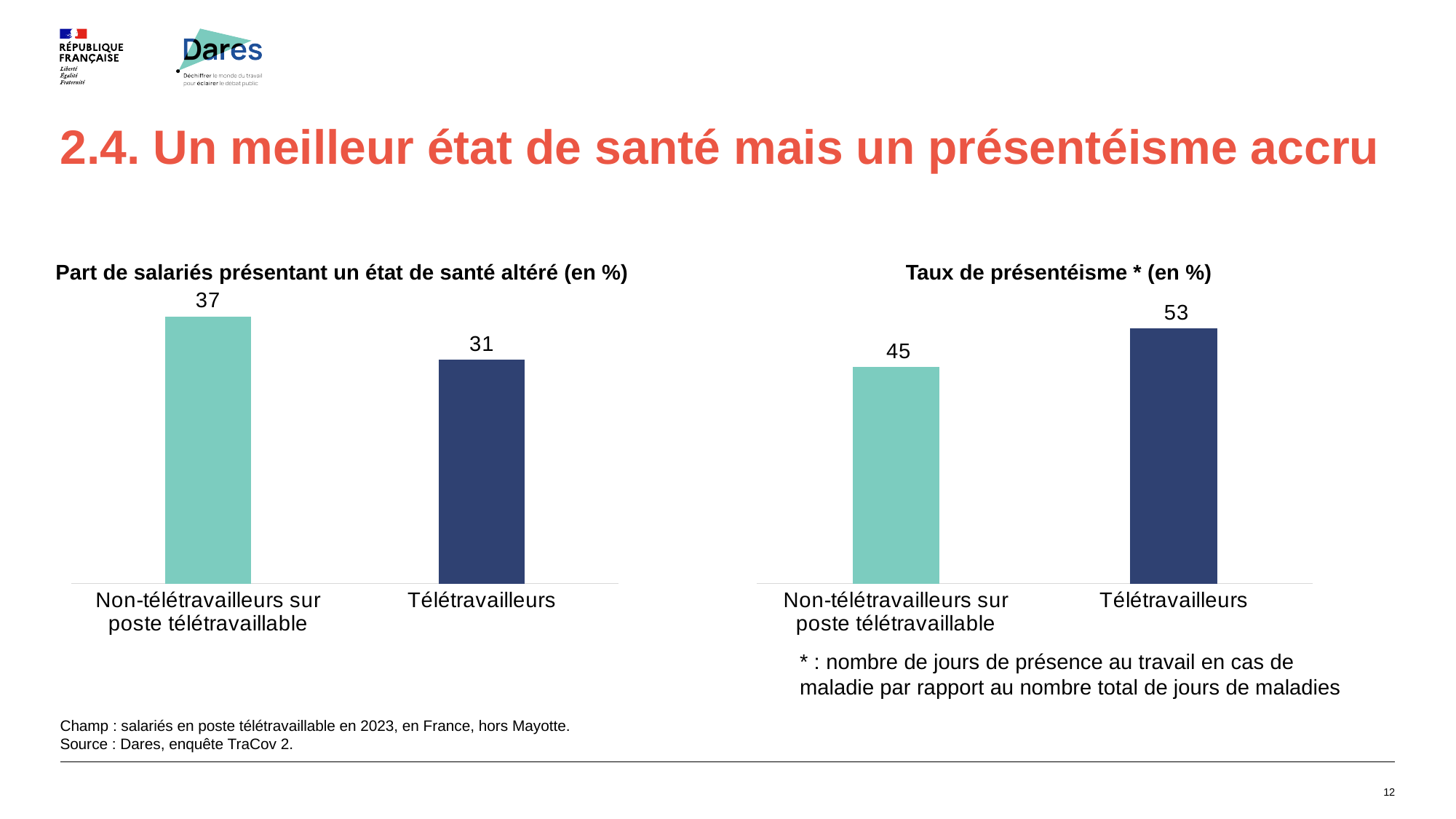
How many charts are shown on the slide? 2 What type of chart is the chart 'Taux de présentéisme * (en %)'? Bar chart In the chart 'Part de salariés présentant un état de santé altéré (en %)', which category has the highest value? Non-télétravailleurs sur poste télétravaillable In the chart 'Taux de présentéisme * (en %)', what is the value for Non-télétravailleurs sur poste télétravaillable? 45 In the chart 'Part de salariés présentant un état de santé altéré (en %)', what is the value for Télétravailleurs? 31 In the chart 'Taux de présentéisme * (en %)', what is the difference between the values for Télétravailleurs and Non-télétravailleurs sur poste télétravaillable? 8 In the chart 'Taux de présentéisme * (en %)', what is the value for Télétravailleurs? 53 In the chart 'Part de salariés présentant un état de santé altéré (en %)', what is the value for Non-télétravailleurs sur poste télétravaillable? 37 In the chart 'Taux de présentéisme * (en %)', which category has the lowest value? Non-télétravailleurs sur poste télétravaillable How many categories are shown in the chart 'Part de salariés présentant un état de santé altéré (en %)'? 2 In the chart 'Taux de présentéisme * (en %)', which is larger: the value for Télétravailleurs or for Non-télétravailleurs sur poste télétravaillable? Télétravailleurs In the chart 'Part de salariés présentant un état de santé altéré (en %)', what is the difference between the values for Non-télétravailleurs sur poste télétravaillable and Télétravailleurs? 6